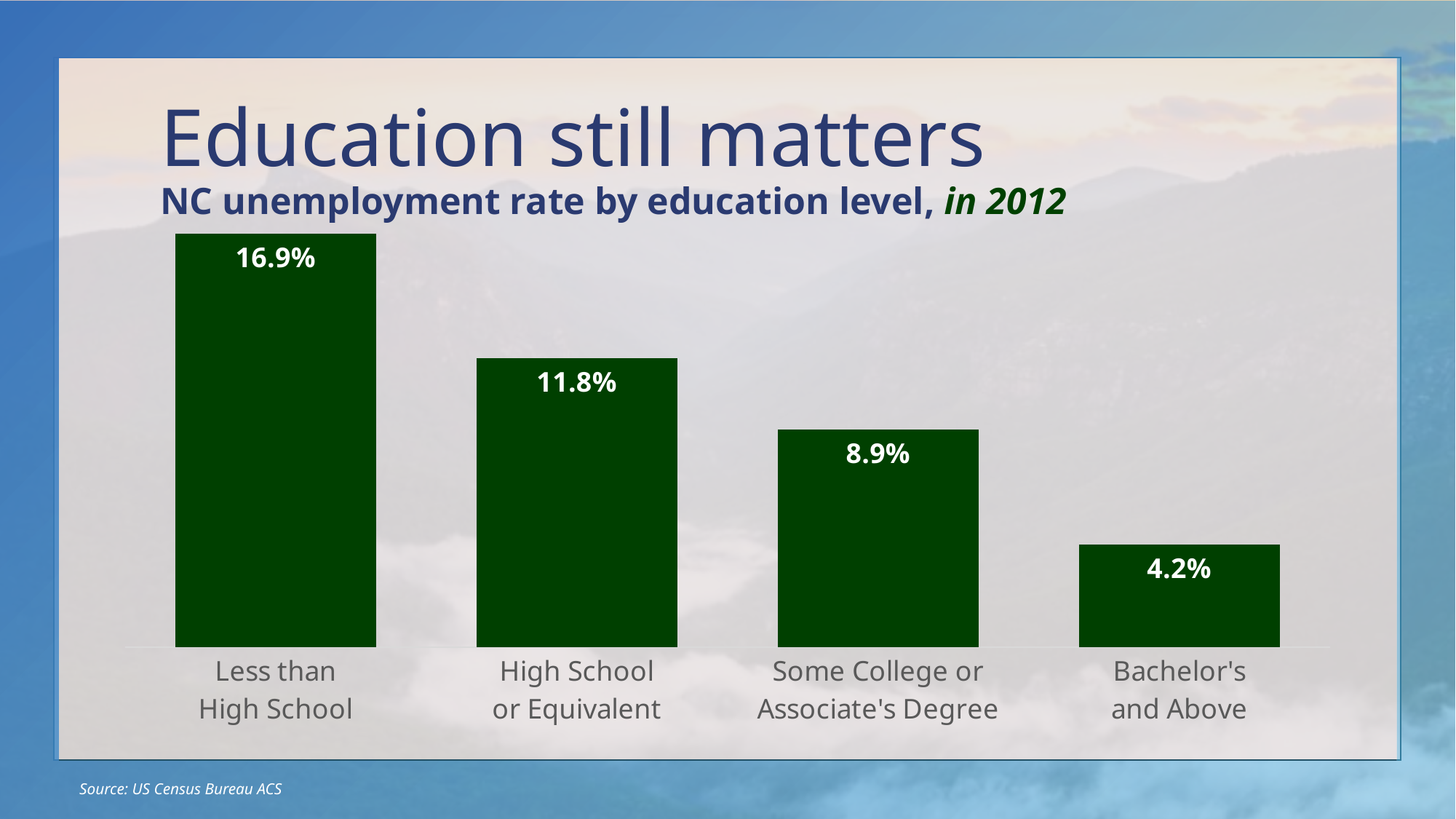
What is the unemployment rate for Some College or Associate's Degree? 8.9% What is the difference between the unemployment rates for High School or Equivalent and Some College or Associate's Degree? 2.9% Which education level has the lowest unemployment rate? Bachelor's and Above Do the unemployment rates rise or fall as education level increases from left to right? Fall What is the difference between the unemployment rates for Less than High School and Bachelor's and Above? 12.7% Which has a higher unemployment rate, High School or Equivalent or Some College or Associate's Degree? High School or Equivalent What kind of chart is shown on the slide? Bar chart How many education levels are shown in the chart? 4 Which education level has the highest unemployment rate? Less than High School What is the unemployment rate for High School or Equivalent? 11.8% What is the unemployment rate for Less than High School? 16.9% What is the unemployment rate for Bachelor's and Above? 4.2%